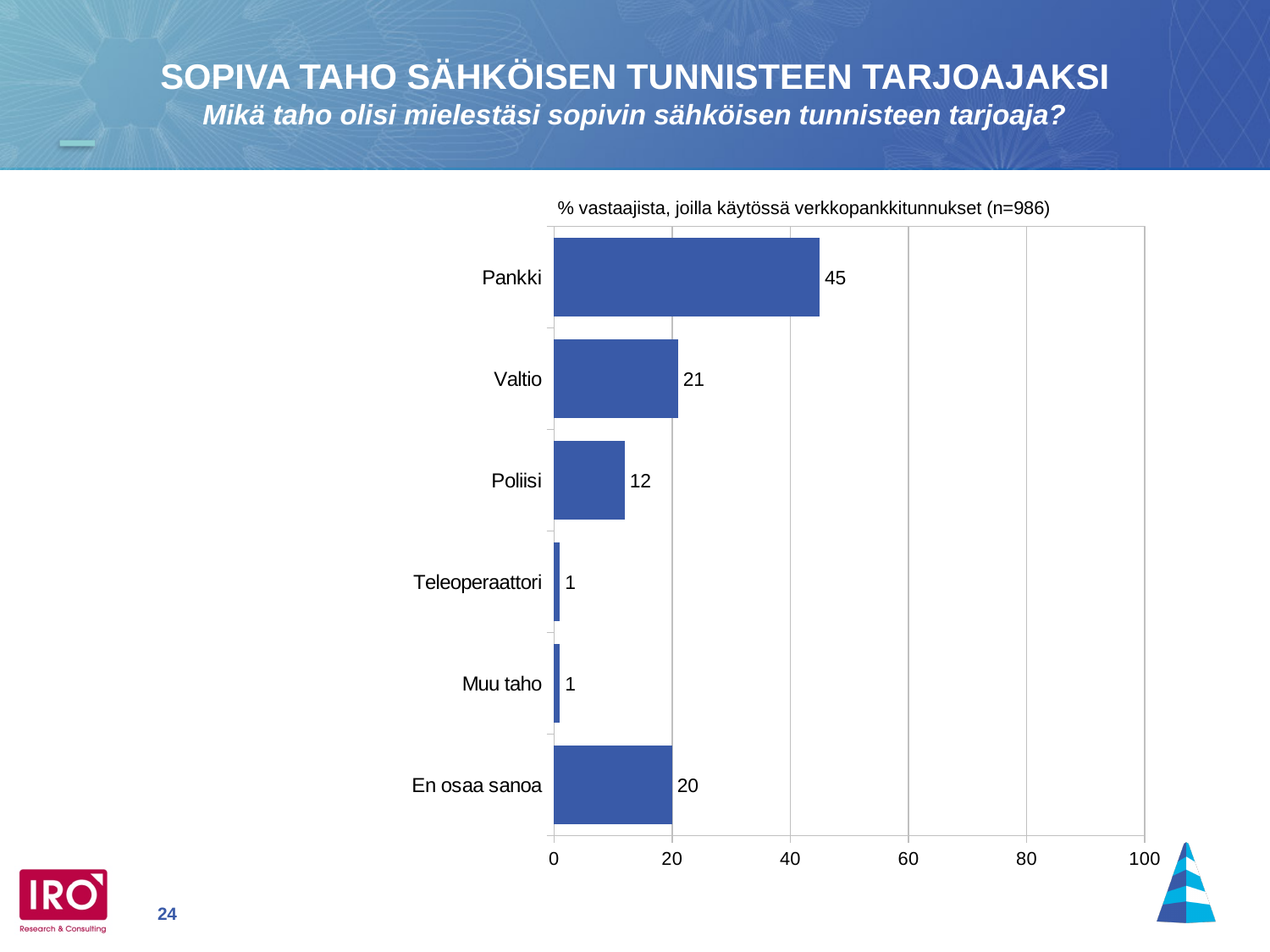
What is the value for Pankki? 45 What kind of chart is shown on the slide? bar chart What is the value for En osaa sanoa? 20 How many categories are shown in the chart? 6 Which category has the highest value? Pankki What is the value for Valtio? 21 Which is larger, the value for Valtio or the value for En osaa sanoa? Valtio Is the value for Pankki greater or less than 40? greater What is the difference between the values for Pankki and Valtio? 24 What is the value for Poliisi? 12 What is the maximum value shown on the x axis? 100 What is the value for Teleoperaattori? 1